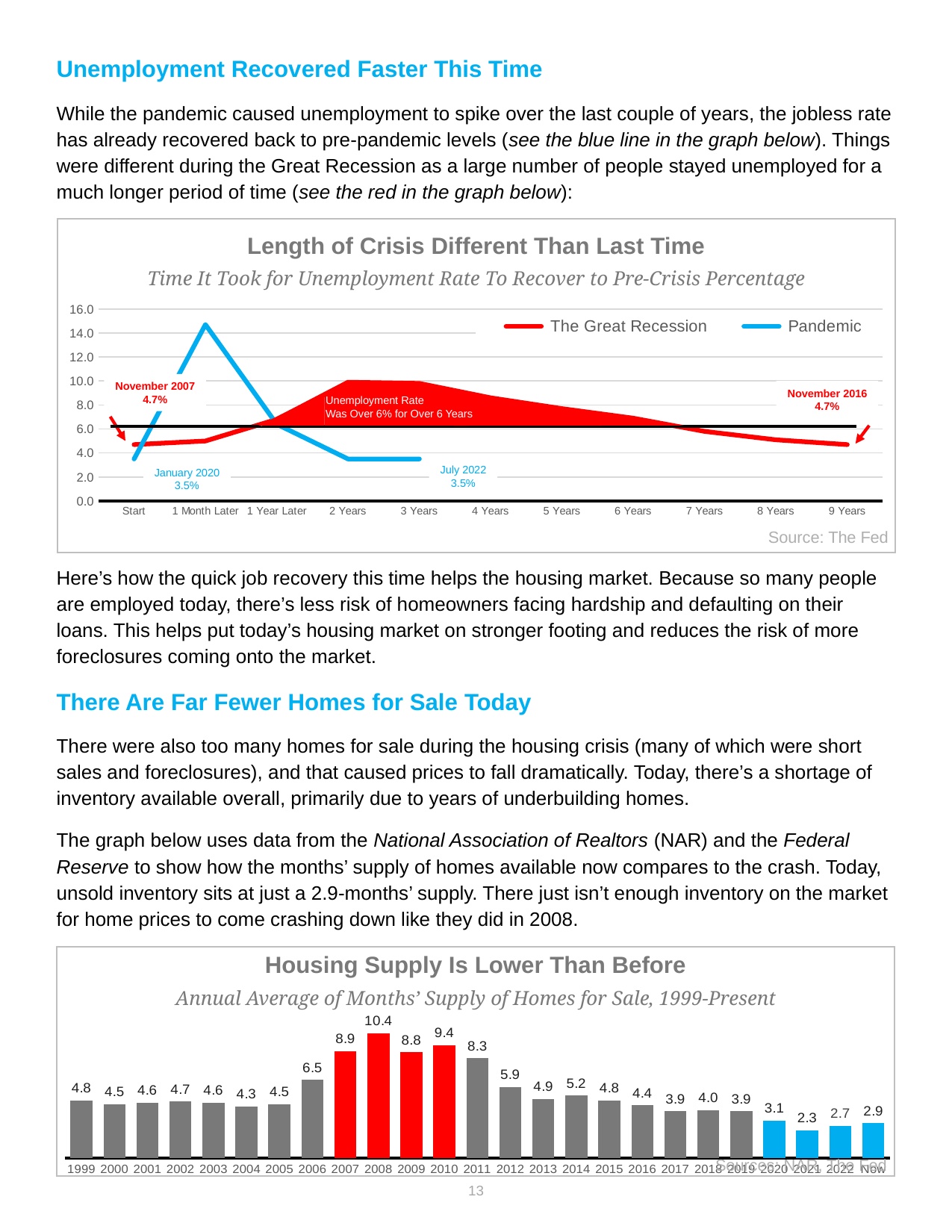
In the 'Length of Crisis Different Than Last Time' chart, how many series does the legend list? 2 In the 'Length of Crisis Different Than Last Time' chart, what unemployment rate is labeled for January 2020? 3.5% In the 'Housing Supply Is Lower Than Before' chart, what is the difference between the 2008 value and the 'Now' value? 7.5 In the 'Length of Crisis Different Than Last Time' chart, is the Pandemic value at '1 Month Later' greater or less than 12.0? greater In the 'Housing Supply Is Lower Than Before' chart, what is the value for 2011? 8.3 In the 'Length of Crisis Different Than Last Time' chart, how many categories are on the x axis? 11 In the 'Housing Supply Is Lower Than Before' chart, which is larger, the value for 2006 or the value for 2012? 2006 In the 'Housing Supply Is Lower Than Before' chart, which year has the lowest months' supply? 2021 In the 'Length of Crisis Different Than Last Time' chart, what type of chart is shown? Line chart In the 'Length of Crisis Different Than Last Time' chart, what unemployment rate is labeled for November 2016? 4.7% In the 'Housing Supply Is Lower Than Before' chart, which year has the highest months' supply? 2008 In the 'Length of Crisis Different Than Last Time' chart, which series is drawn in blue? Pandemic